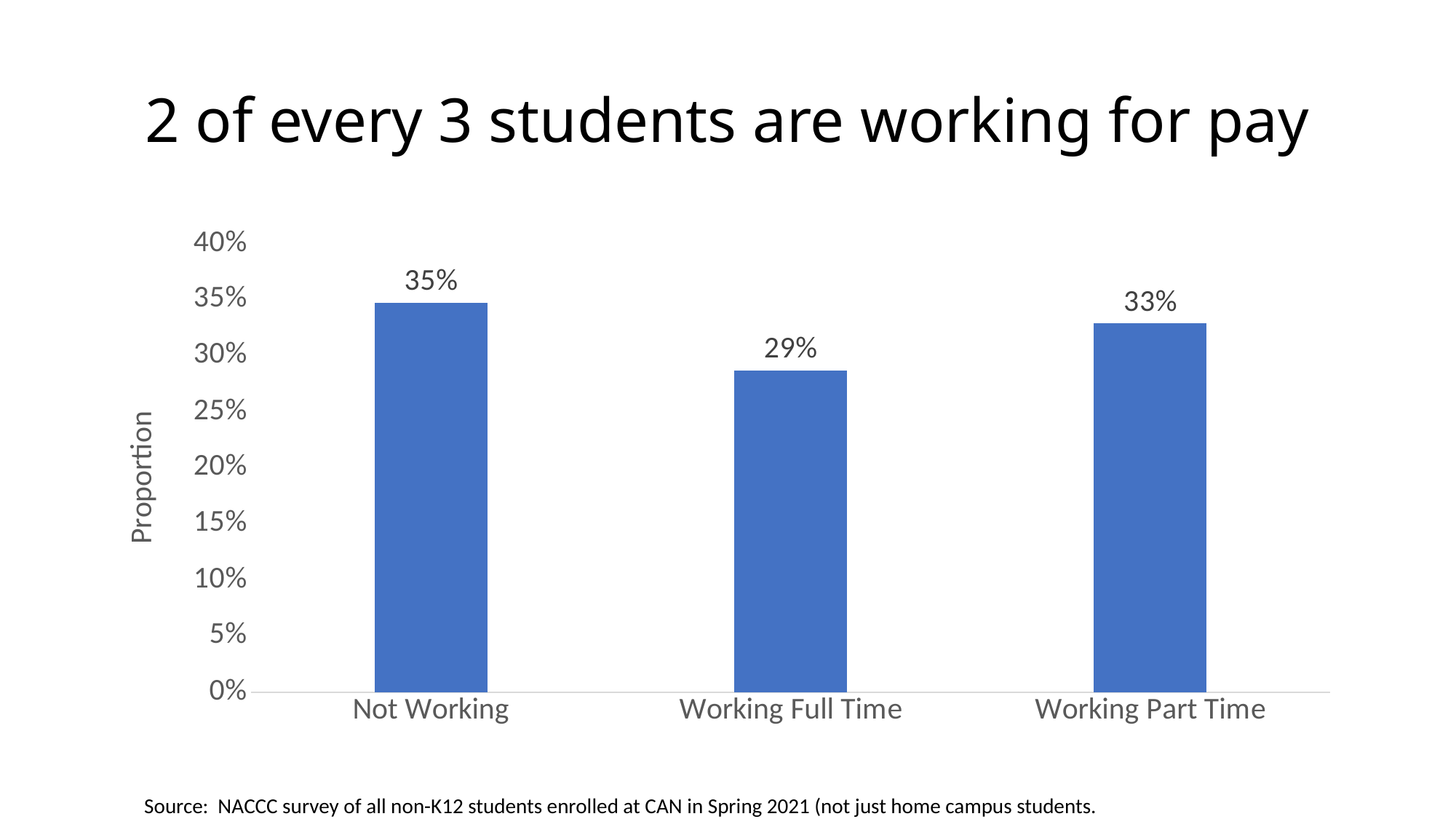
Which is larger, the value for Working Part Time or the value for Working Full Time? Working Part Time How many categories are shown on the chart? 3 What is the value for Not Working? 35% Is the value for Working Full Time greater or less than 30%? less What is the difference between the values for Working Part Time and Working Full Time? 4% What is the value for Working Part Time? 33% Which category has the highest value? Not Working What is the label on the vertical axis of the chart? Proportion Which category has the lowest value? Working Full Time What is the value for Working Full Time? 29% What kind of chart is shown on the slide? bar chart What is the difference between the values for Not Working and Working Full Time? 6%